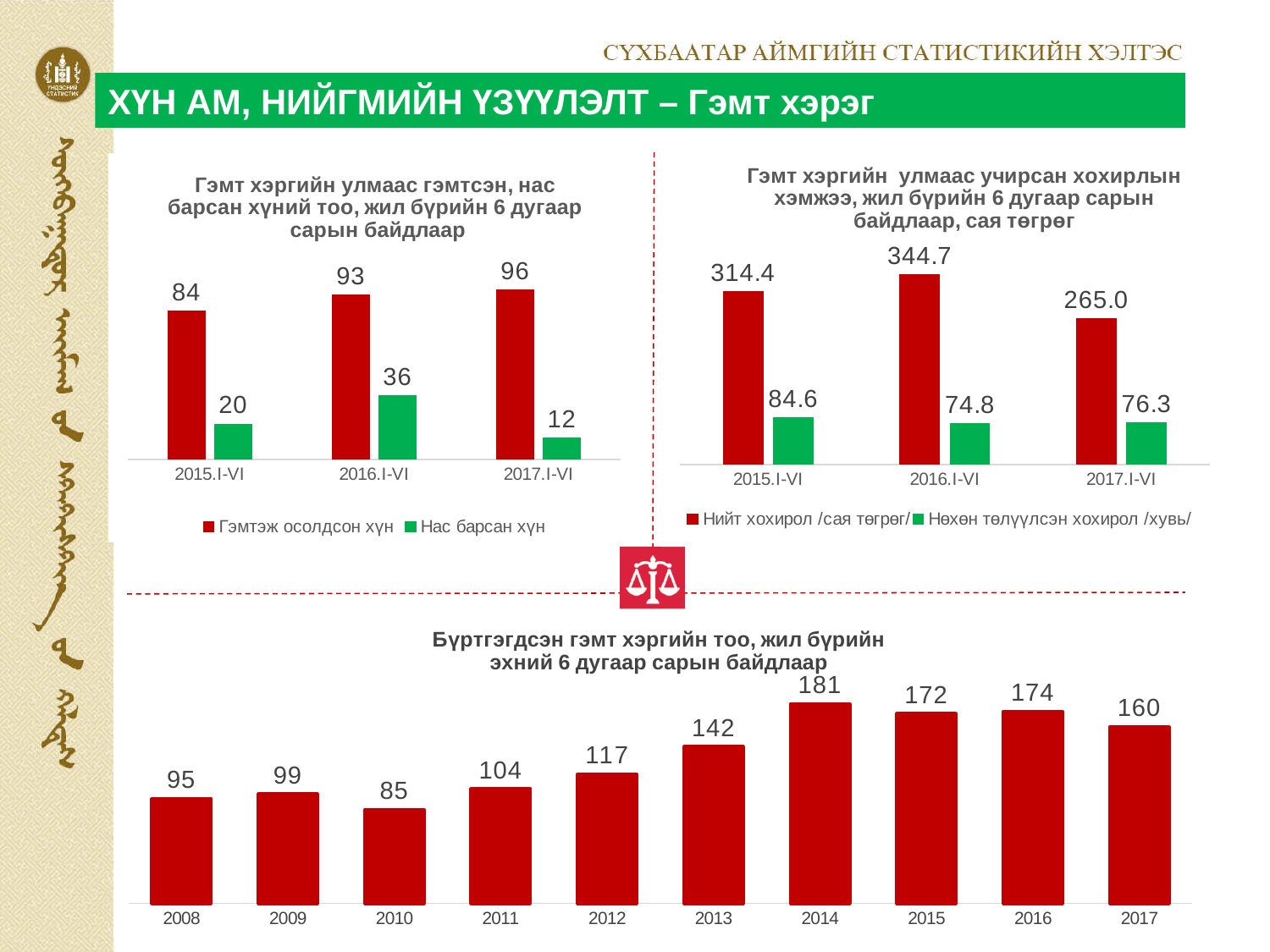
How many years are shown on the x axis of the bottom chart? 10 In the bottom chart, what is the value for 2014? 181 In the top-left chart, which year has the highest value for 'Гэмтэж осолдсон хүн'? 2017.I-VI How many series does the legend of the top-left chart list? 2 In the bottom chart, what is the difference between the values for 2016 and 2017? 14 In the top-right chart, what is the value for 'Нөхөн төлүүлсэн хохирол /хувь/' in 2015.I-VI? 84.6 In the top-right chart, which year has the lowest value for 'Нийт хохирол /сая төгрөг/'? 2017.I-VI In the bottom chart, which year has the lowest value? 2010 In the top-right chart, what is the value for 'Нийт хохирол /сая төгрөг/' in 2016.I-VI? 344.7 What kind of chart is the bottom chart? Bar chart In the top-left chart, what is the difference between 'Гэмтэж осолдсон хүн' and 'Нас барсан хүн' in 2015.I-VI? 64 In the top-left chart, what is the value for 'Нас барсан хүн' in 2016.I-VI? 36